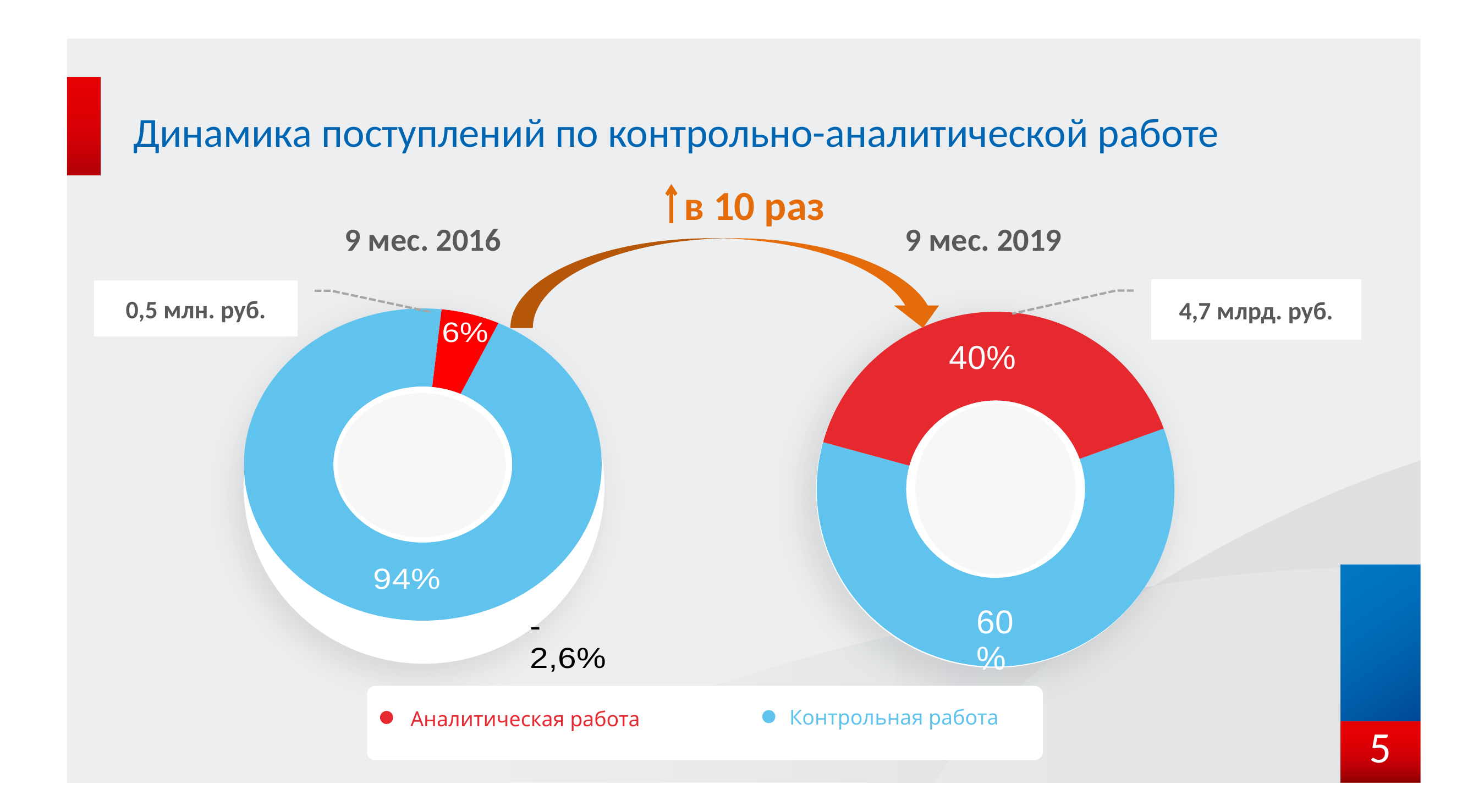
In the "9 мес. 2019" chart, what share is labelled for Контрольная работа? 60% In the "9 мес. 2016" chart, which category has the largest share? Контрольная работа In the "9 мес. 2019" chart, which category has the smallest share? Аналитическая работа In the "9 мес. 2019" chart, what share is labelled for Аналитическая работа? 40% In the "9 мес. 2016" chart, what share is labelled for Контрольная работа? 94% Which chart shows a larger share for Аналитическая работа, "9 мес. 2016" or "9 мес. 2019"? 9 мес. 2019 In the "9 мес. 2016" chart, what share is labelled for Аналитическая работа? 6% What colour represents Контрольная работа in the charts? Blue How many entries does the legend list? 2 In the "9 мес. 2016" chart, what is the difference in percentage points between Контрольная работа and Аналитическая работа? 88 What type of chart is used on this slide? Donut (pie) chart In the "9 мес. 2019" chart, what is the difference in percentage points between Контрольная работа and Аналитическая работа? 20